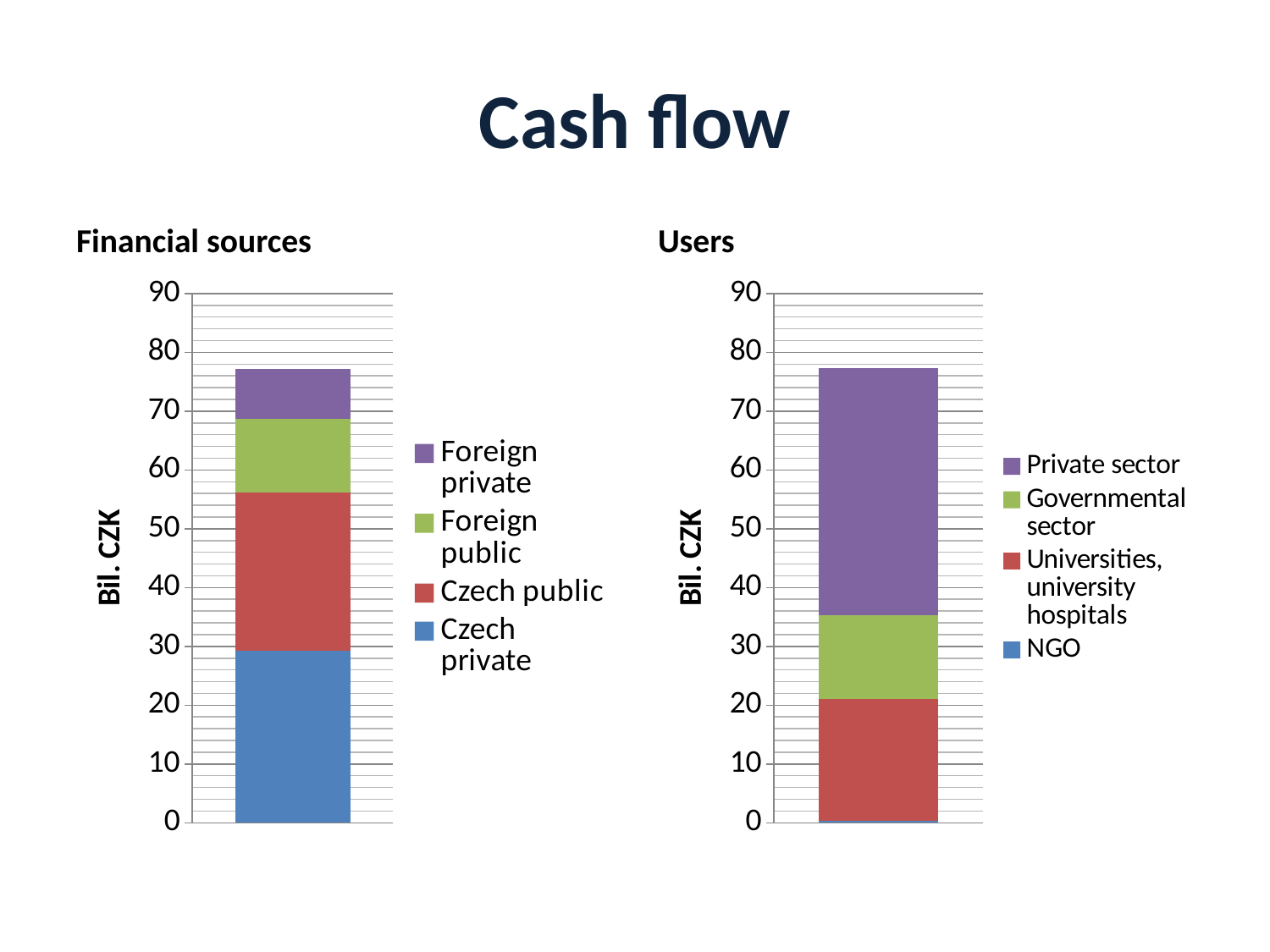
How many series does the legend of the Financial sources chart list? 4 How many series does the legend of the Users chart list? 4 In the Financial sources chart, which segment is larger: Czech public or Foreign private? Czech public What is the title of the chart on the left of the slide? Financial sources In the Users chart, which series has the smallest segment? NGO In the Users chart, is the total height of the stacked bar greater or less than 80? less In the Users chart, which segment is larger: Private sector or Governmental sector? Private sector What kind of chart is the Financial sources chart? Stacked bar chart In the Financial sources chart, is the total height of the stacked bar greater or less than 70? greater In the Users chart, which series has the largest segment? Private sector What is the y-axis label on the Users chart? Bil. CZK In the Financial sources chart, which series has the smallest segment? Foreign private